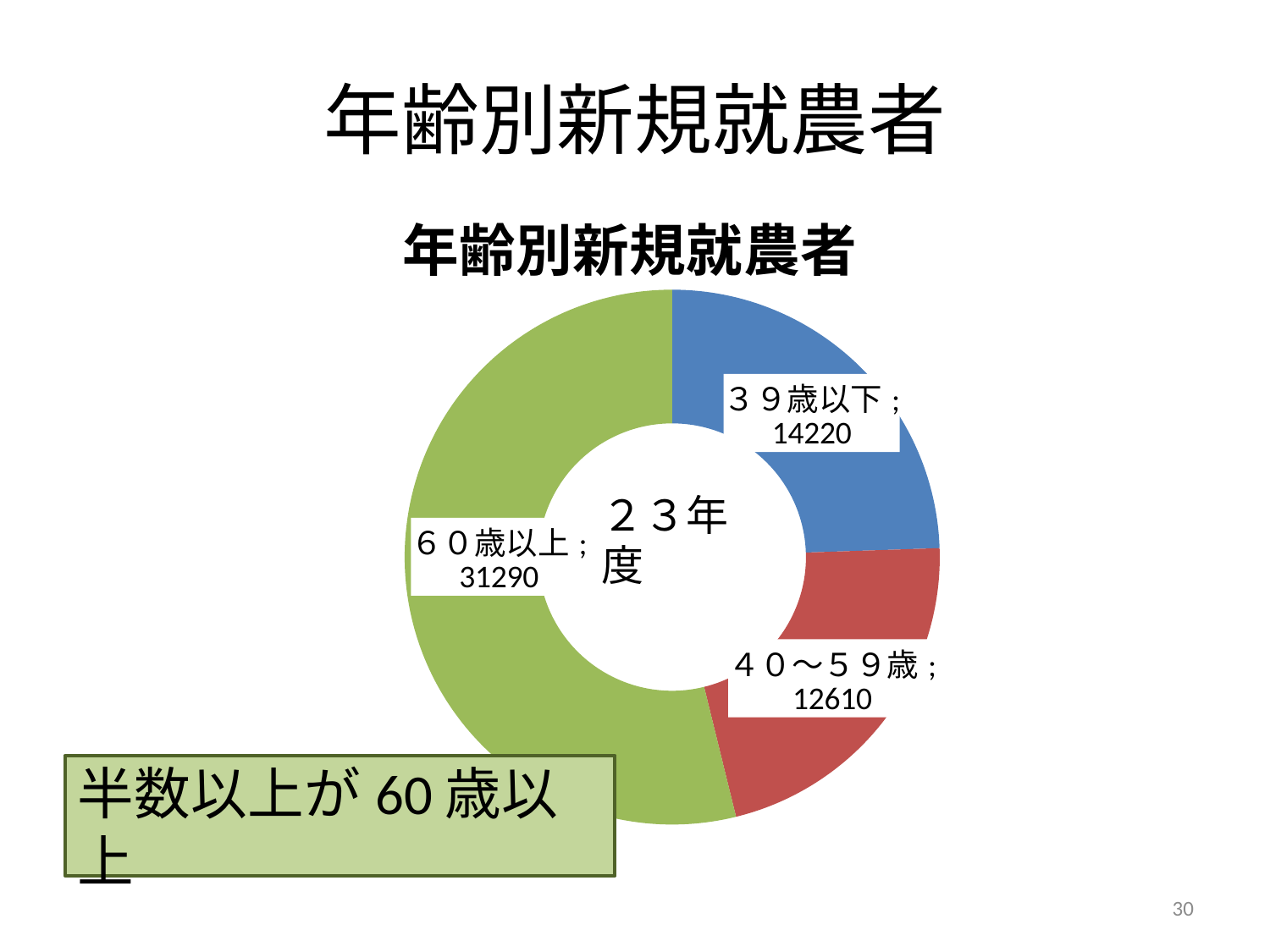
What is the difference between the values for 60歳以上 and 39歳以下 in the 年齢別新規就農者 chart? 17070 What is the value for 60歳以上 in the 年齢別新規就農者 chart? 31290 How many age groups are shown in the 年齢別新規就農者 chart? 3 What is the difference between the values for 39歳以下 and 40～59歳 in the 年齢別新規就農者 chart? 1610 Which age group has the highest value in the 年齢別新規就農者 chart? 60歳以上 What kind of chart is the 年齢別新規就農者 chart? doughnut chart What is the value for 39歳以下 in the 年齢別新規就農者 chart? 14220 What text is shown in the centre of the 年齢別新規就農者 doughnut chart? ２３年度 What is the value for 40～59歳 in the 年齢別新規就農者 chart? 12610 Which is larger in the 年齢別新規就農者 chart, 60歳以上 or 40～59歳? 60歳以上 What is the total of all three age groups in the 年齢別新規就農者 chart? 58120 Which age group has the lowest value in the 年齢別新規就農者 chart? 40～59歳